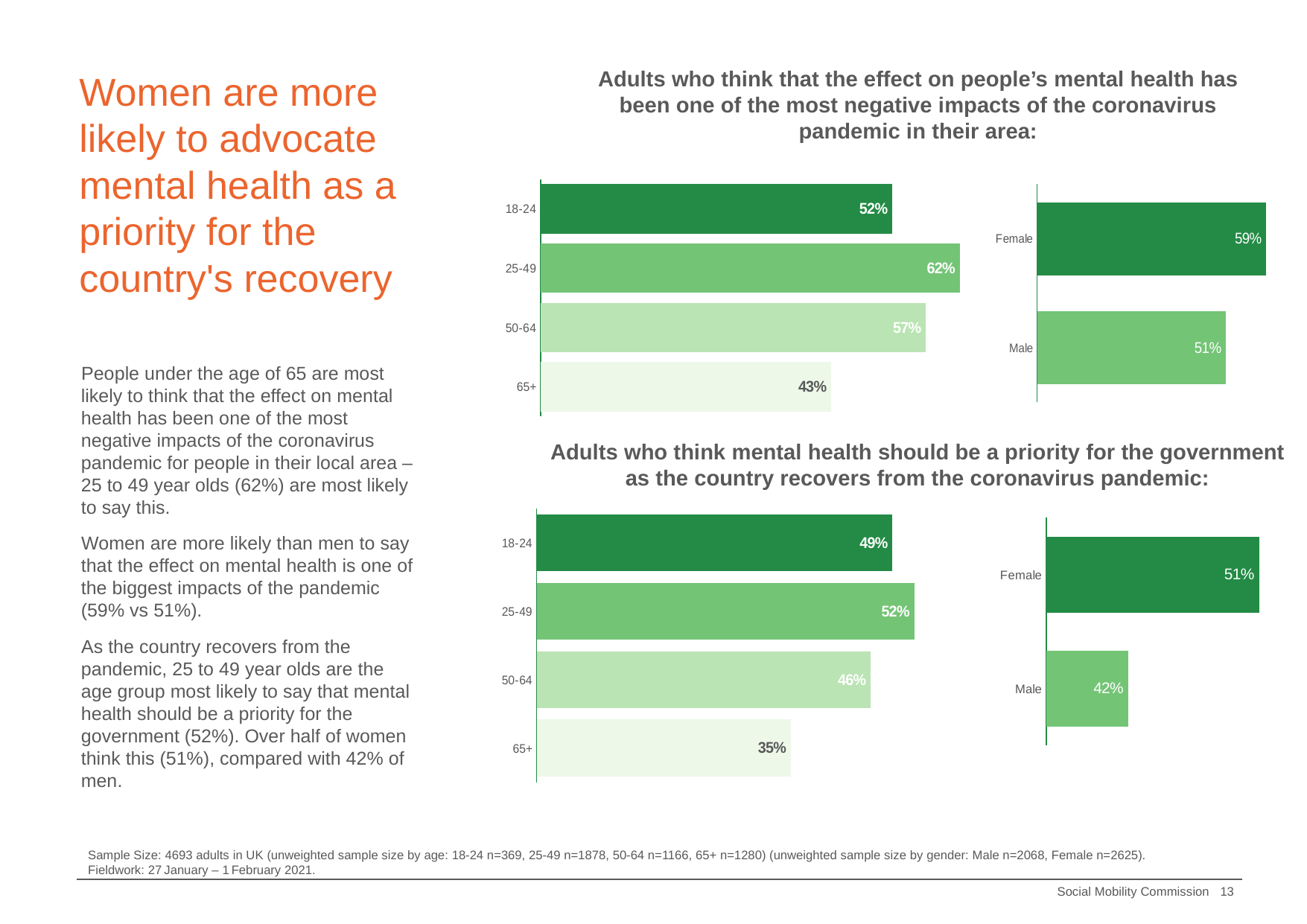
In the bottom chart on mental health being a priority for the government, what is the difference between the 25-49 and 65+ values? 17 percentage points In the bottom chart on mental health being a priority for the government, which is larger, the value for 50-64 or the value for 65+? 50-64 In the top chart on the effect on mental health being one of the most negative impacts, what is the difference between the Female and Male values? 8 percentage points In the top chart on the effect on mental health being one of the most negative impacts, what percentage of 25-49 year olds say this? 62% In the top chart on the effect on mental health being one of the most negative impacts, what is the value for 50-64 year olds? 57% What type of chart is used in the bottom chart on mental health being a priority for the government? Bar chart In the top chart on the effect on mental health being one of the most negative impacts, which age group has the lowest value? 65+ How many age groups are shown in the top chart on the effect on mental health being one of the most negative impacts? 4 In the top chart on the effect on mental health being one of the most negative impacts, what percentage of women say this? 59% In the bottom chart on mental health being a priority for the government, what percentage of 18-24 year olds say this? 49% In the bottom chart on mental health being a priority for the government, which age group has the highest value? 25-49 In the bottom chart on mental health being a priority for the government, what percentage of men say this? 42%